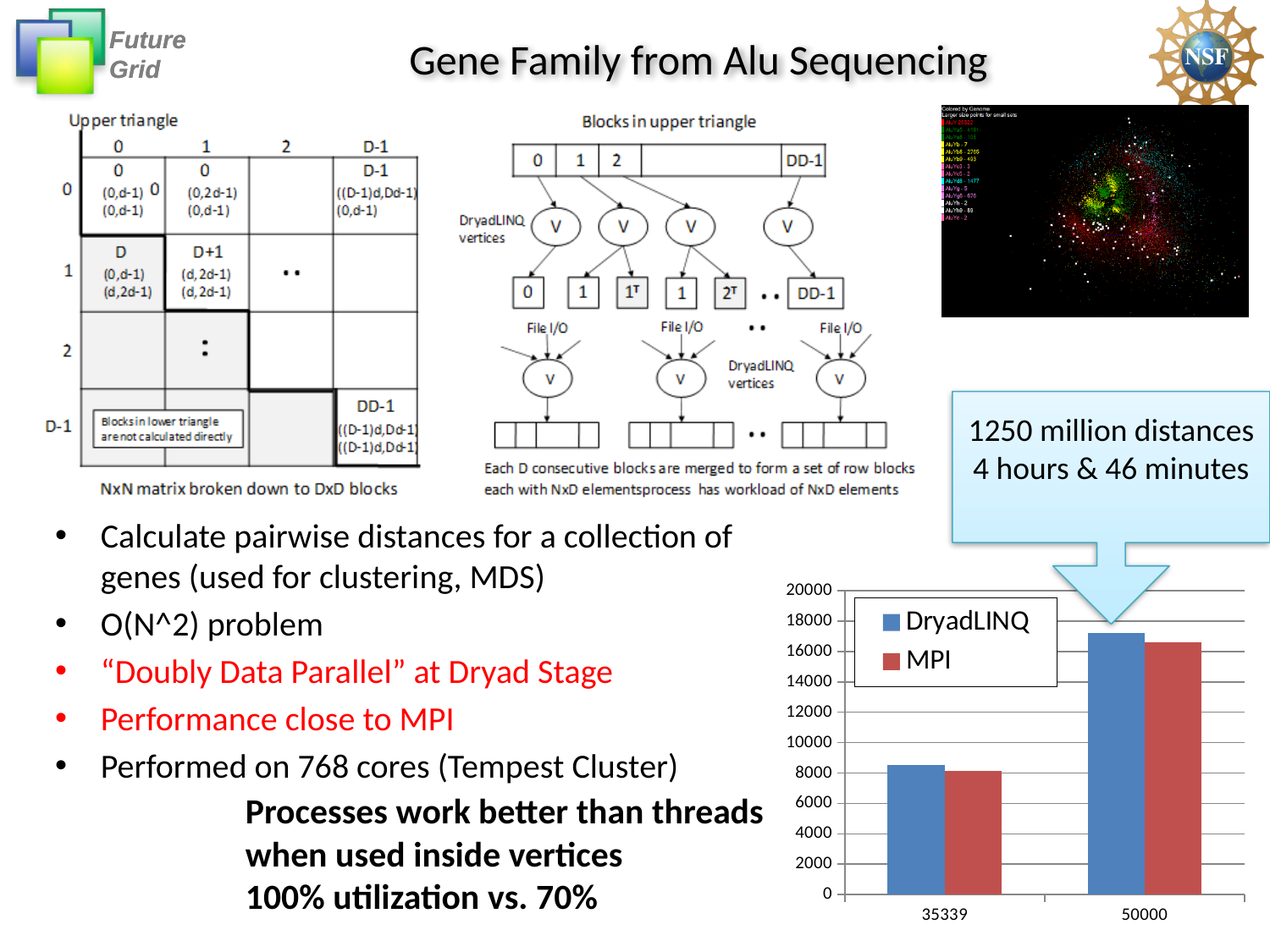
Which colour represents MPI in the bar chart? red What kind of chart is shown at the bottom right of the slide? bar chart Do the values in the bar chart rise or fall from 35339 to 50000? rise Which bar in the bar chart is the tallest? DryadLINQ at 50000 In the bar chart, is the DryadLINQ value for 35339 greater or less than 8000? greater In the bar chart, is the MPI value for 35339 greater or less than 10000? less In the bar chart, is the DryadLINQ value for 50000 greater or less than 16000? greater How many series does the legend of the bar chart list? 2 How many categories are shown on the x axis of the bar chart? 2 What are the two series named in the bar chart's legend? DryadLINQ and MPI In the bar chart, which series has the larger value for 50000, DryadLINQ or MPI? DryadLINQ